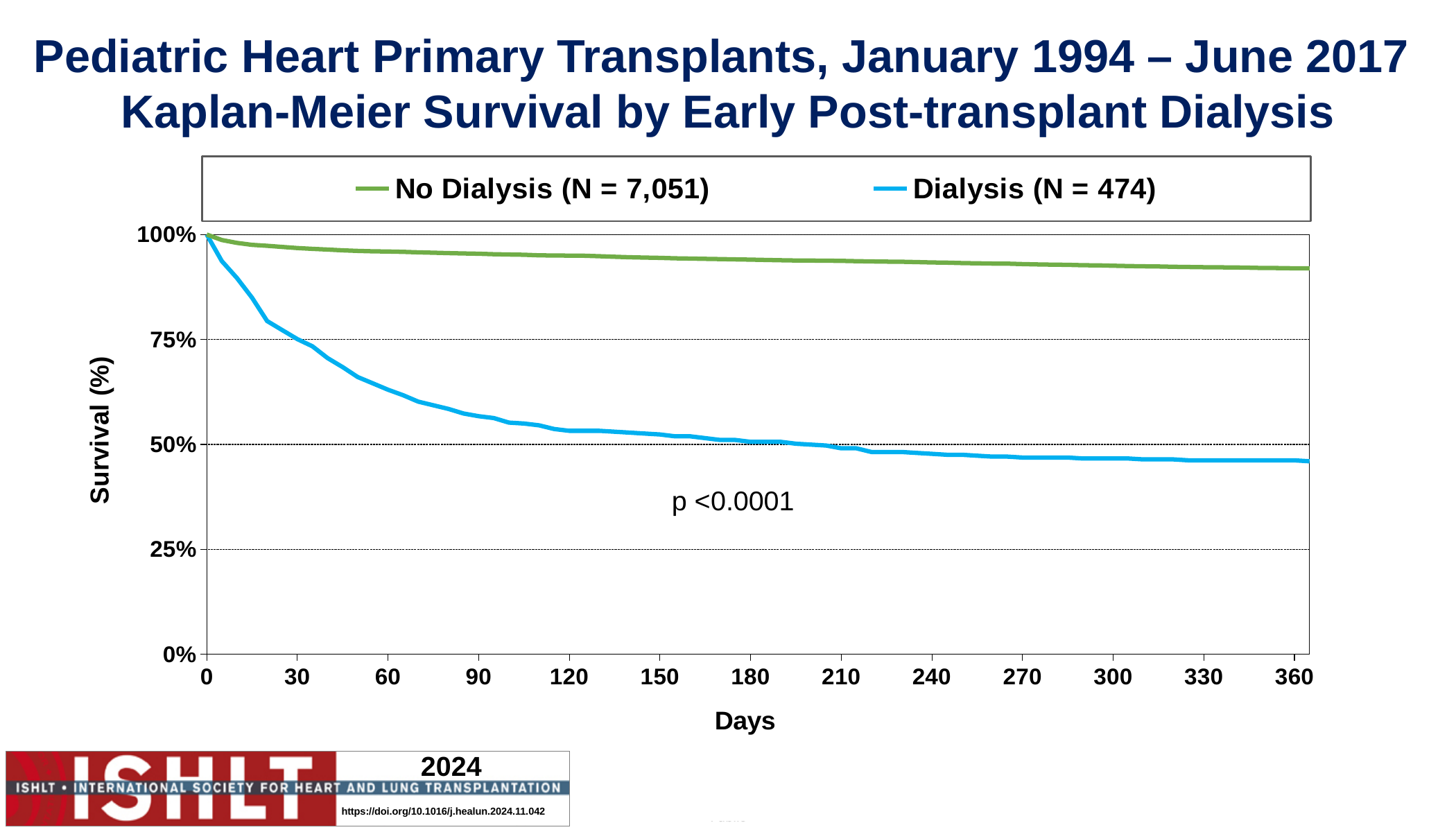
Is the survival value for the Dialysis group at day 360 greater or less than 50%? less What p-value is printed on the chart? p <0.0001 What kind of chart is shown on the slide? line chart Is the survival value for the Dialysis group at day 90 greater or less than 50%? greater What is the N for the No Dialysis group shown in the legend? 7,051 Is the survival value for the No Dialysis group at day 360 greater or less than 75%? greater Does the survival of the Dialysis group rise or fall as days increase? fall How many series does the legend list? 2 At day 180, which group has the higher survival: No Dialysis or Dialysis? No Dialysis Which group has the lower survival at day 360? Dialysis What is the survival value for both groups at day 0? 100%